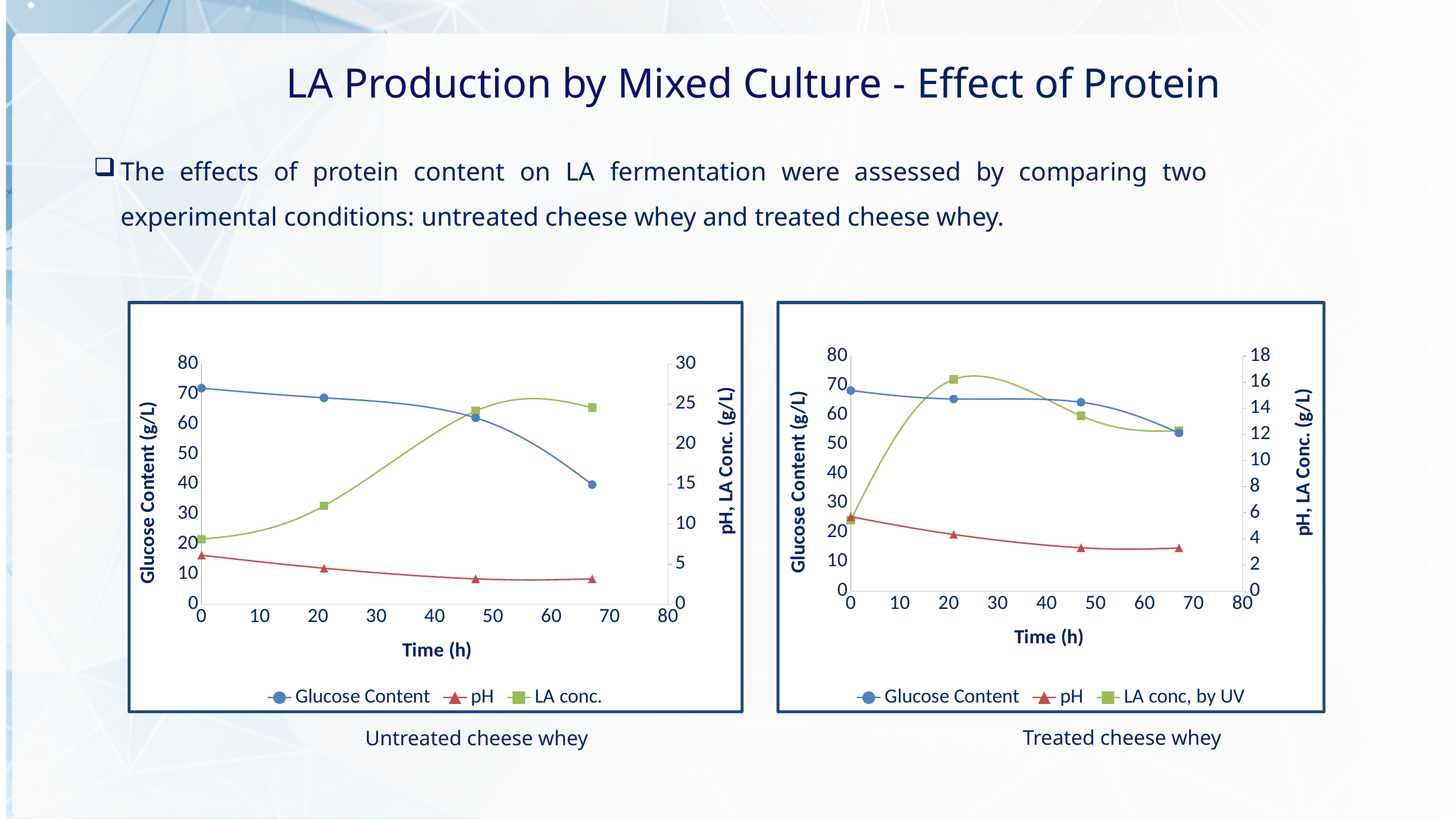
In the 'Untreated cheese whey' chart, does Glucose Content rise or fall over time? fall In the 'Treated cheese whey' chart, is the Glucose Content at the last time point greater or less than 60 g/L? less In the 'Treated cheese whey' chart, is the Glucose Content at time 0 greater or less than 60 g/L? greater In the 'Treated cheese whey' chart, which is larger at time 0: Glucose Content or pH? Glucose Content How many series does the legend of the 'Treated cheese whey' chart list? 3 What is the x-axis title of the 'Treated cheese whey' chart? Time (h) What kind of chart is the 'Untreated cheese whey' chart? line chart In the 'Untreated cheese whey' chart, is the LA conc. at the last time point greater or less than 20 g/L? greater In the 'Untreated cheese whey' chart, does pH rise or fall over time? fall How many data points does the Glucose Content series have in the 'Untreated cheese whey' chart? 4